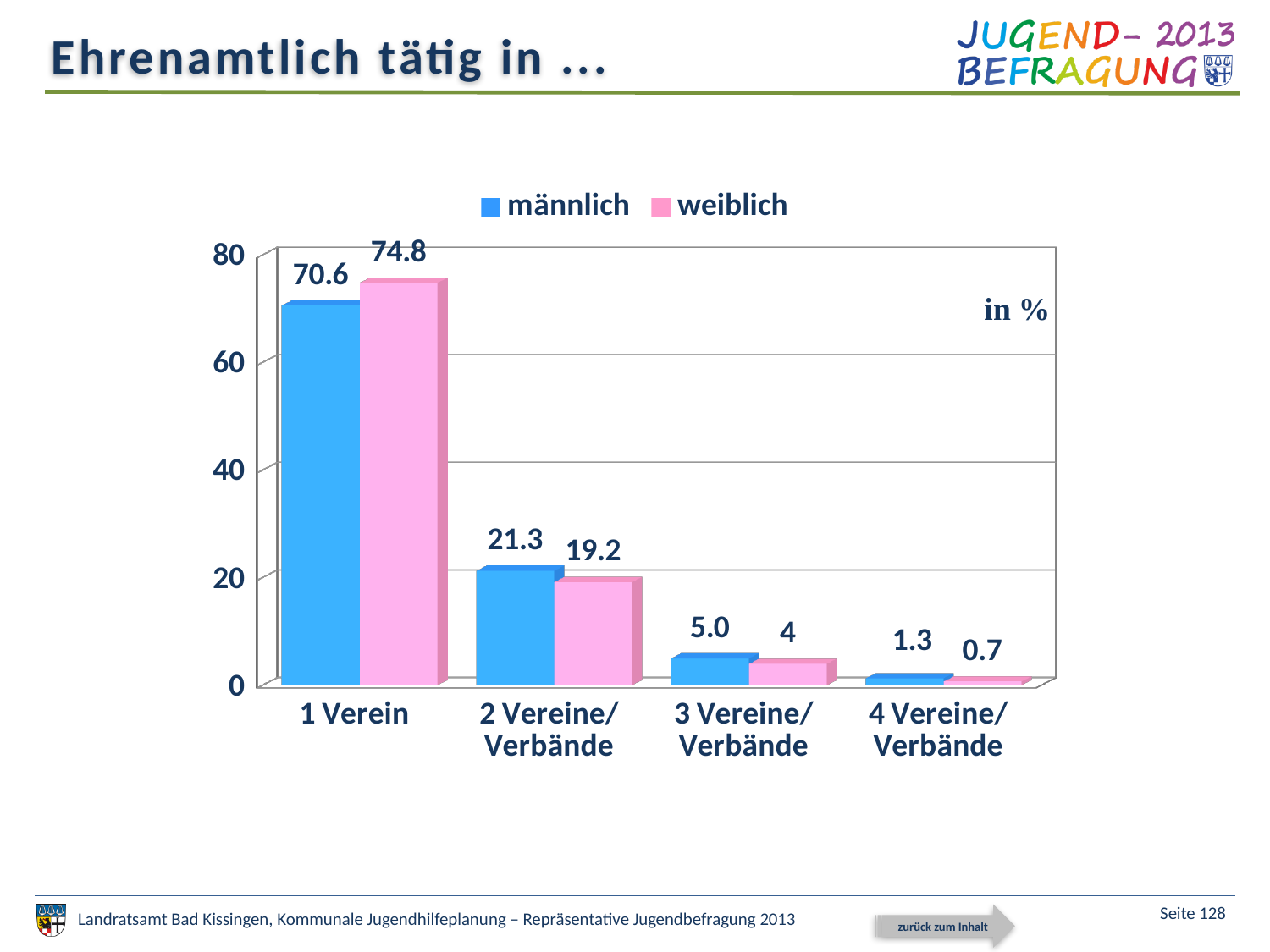
Which category has the lowest value for männlich? 4 Vereine/Verbände How many series does the legend list? 2 What is the value for weiblich in the 2 Vereine/Verbände category? 19.2 What kind of chart is shown on the slide? bar chart What is the value for männlich in the 4 Vereine/Verbände category? 1.3 What is the value for männlich in the 1 Verein category? 70.6 Do the männlich values rise or fall from 1 Verein to 4 Vereine/Verbände? fall What is the value for weiblich in the 3 Vereine/Verbände category? 4 In the 2 Vereine/Verbände category, which series has the larger value, männlich or weiblich? männlich How many categories are shown on the x axis? 4 What is the difference between the weiblich and männlich values in the 1 Verein category? 4.2 Which category has the highest value for weiblich? 1 Verein